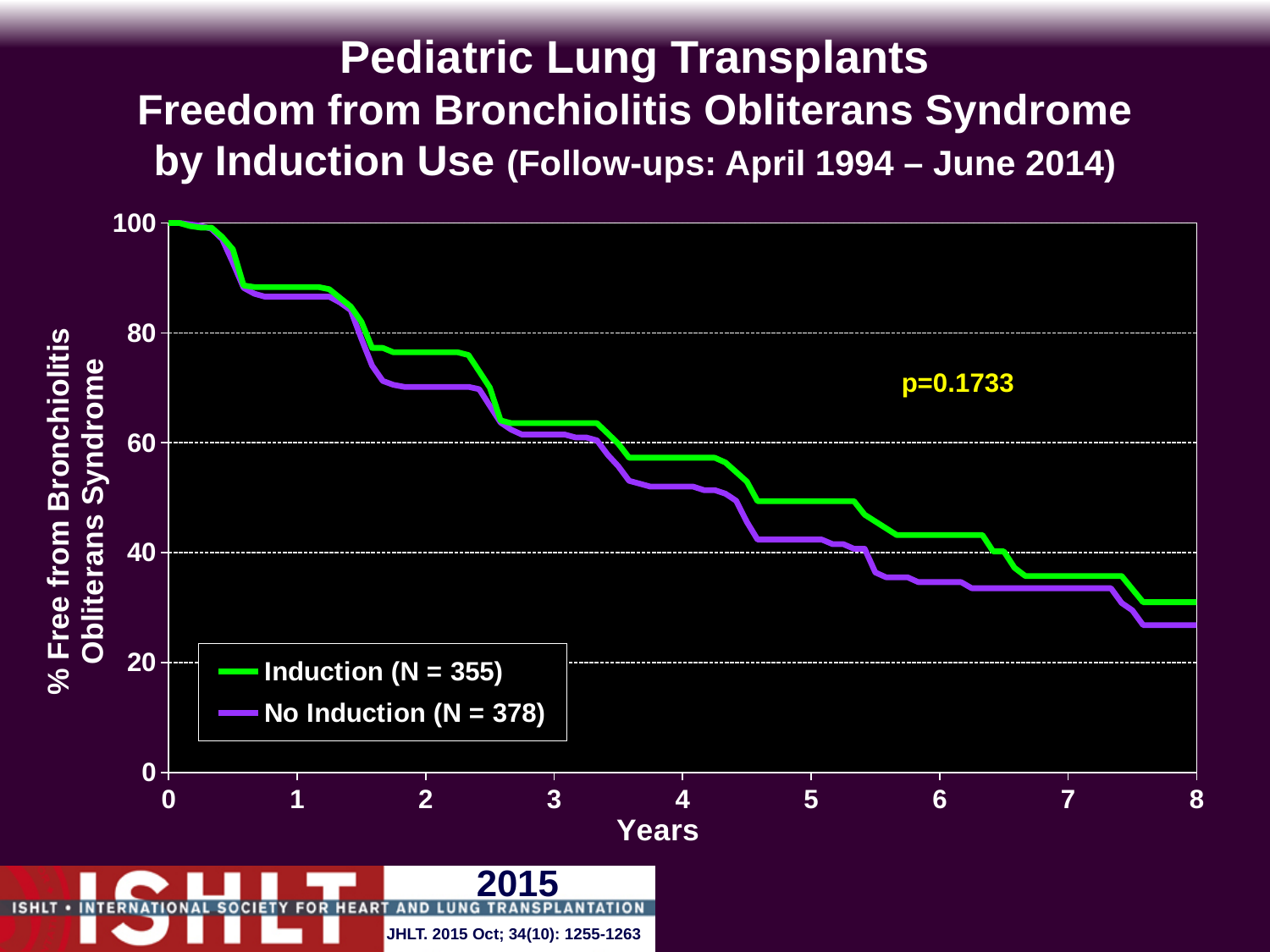
Is the value for Induction at 2 years greater or less than 80? less What kind of chart is shown on the slide? line chart What is the sample size (N) for the Induction group shown in the legend? 355 What p-value is printed on the chart? p=0.1733 Do the curves rise or fall as years increase along the x axis? fall Is the value for Induction at 8 years greater or less than 40? less Is the value for No Induction at 6 years greater or less than 40? less At 8 years, which group has the higher percentage free from Bronchiolitis Obliterans Syndrome, Induction or No Induction? Induction How many series does the legend list? 2 At 5 years, which group has the lower percentage free from Bronchiolitis Obliterans Syndrome, Induction or No Induction? No Induction